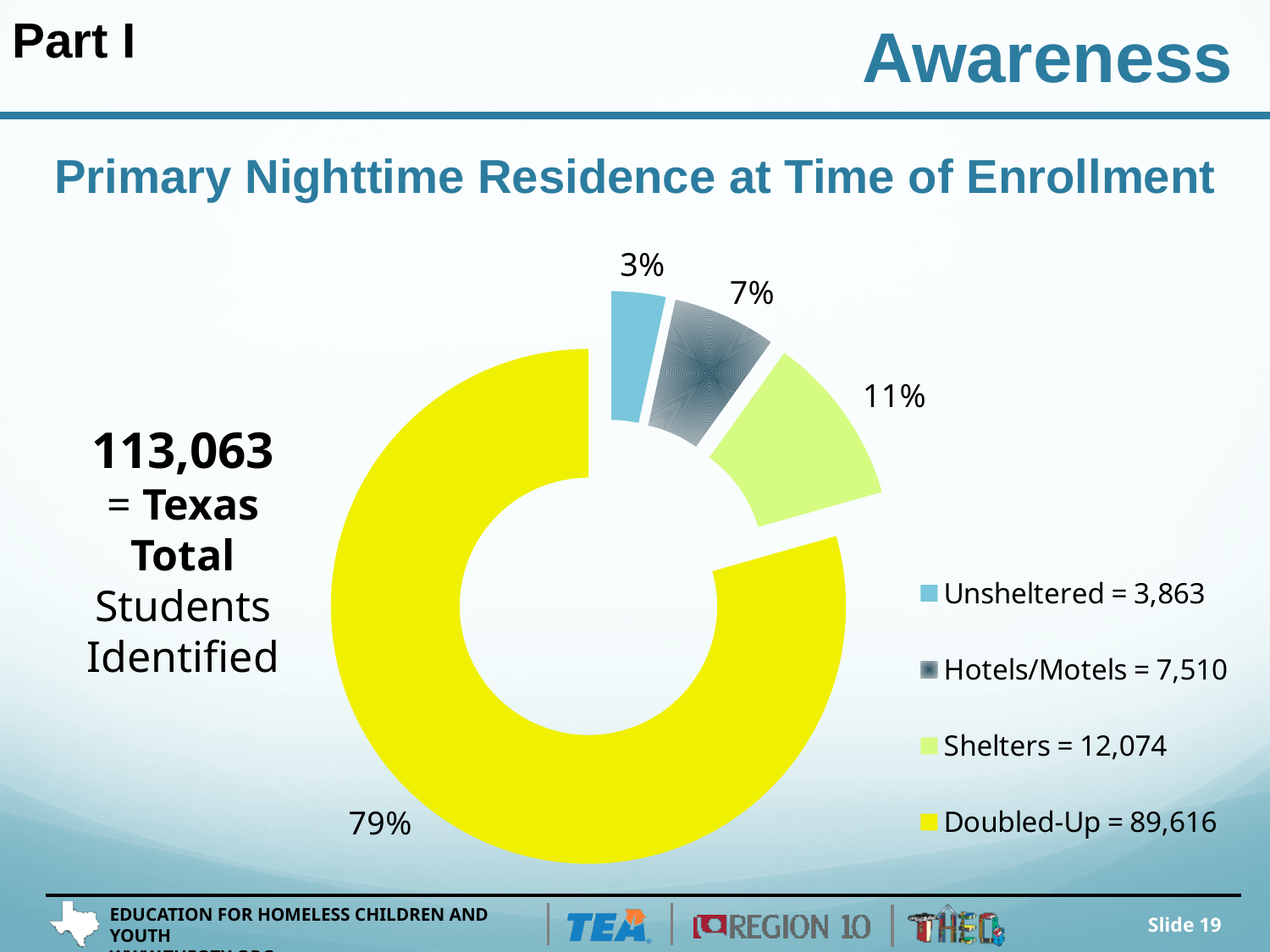
Which category has the smallest slice? Unsheltered What share of the chart does Shelters represent? 11% What share of the chart does Unsheltered represent? 3% Which is larger, the Hotels/Motels slice or the Shelters slice? Shelters What is the title of the chart? Primary Nighttime Residence at Time of Enrollment What is the difference between the Shelters and Hotels/Motels counts? 4,564 What share of the chart does Doubled-Up represent? 79% Which category has the largest slice? Doubled-Up How many categories does the chart show? 4 What kind of chart is shown on the slide? doughnut chart What is the number of students for Doubled-Up according to the legend? 89,616 What is the number of students for Hotels/Motels according to the legend? 7,510